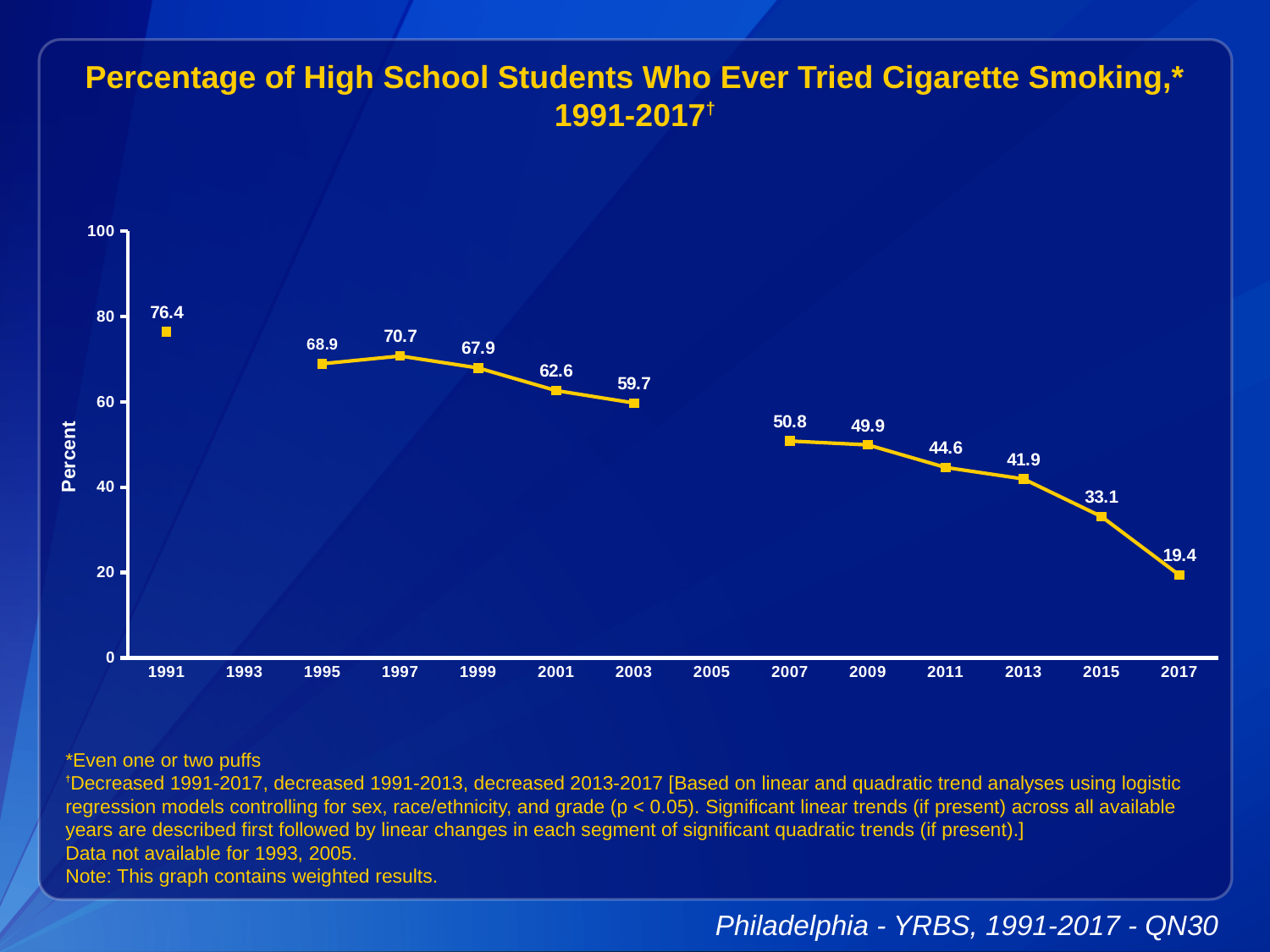
Do the values generally rise or fall from 1991 to 2017? fall What kind of chart is shown on the slide? line chart Which year has a higher value, 1995 or 1997? 1997 Is the value for 2003 greater or less than 60? less What is the difference between the 1991 value and the 2017 value? 57.0 What was the percentage of high school students who ever tried cigarette smoking in 2017? 19.4 What was the percentage of high school students who ever tried cigarette smoking in 1991? 76.4 Which year has the highest percentage of students who ever tried cigarette smoking? 1991 What value is shown for 2007? 50.8 What is the difference between the 2013 value and the 2015 value? 8.8 How many years have data points plotted on the chart? 12 Which year has the lowest percentage of students who ever tried cigarette smoking? 2017